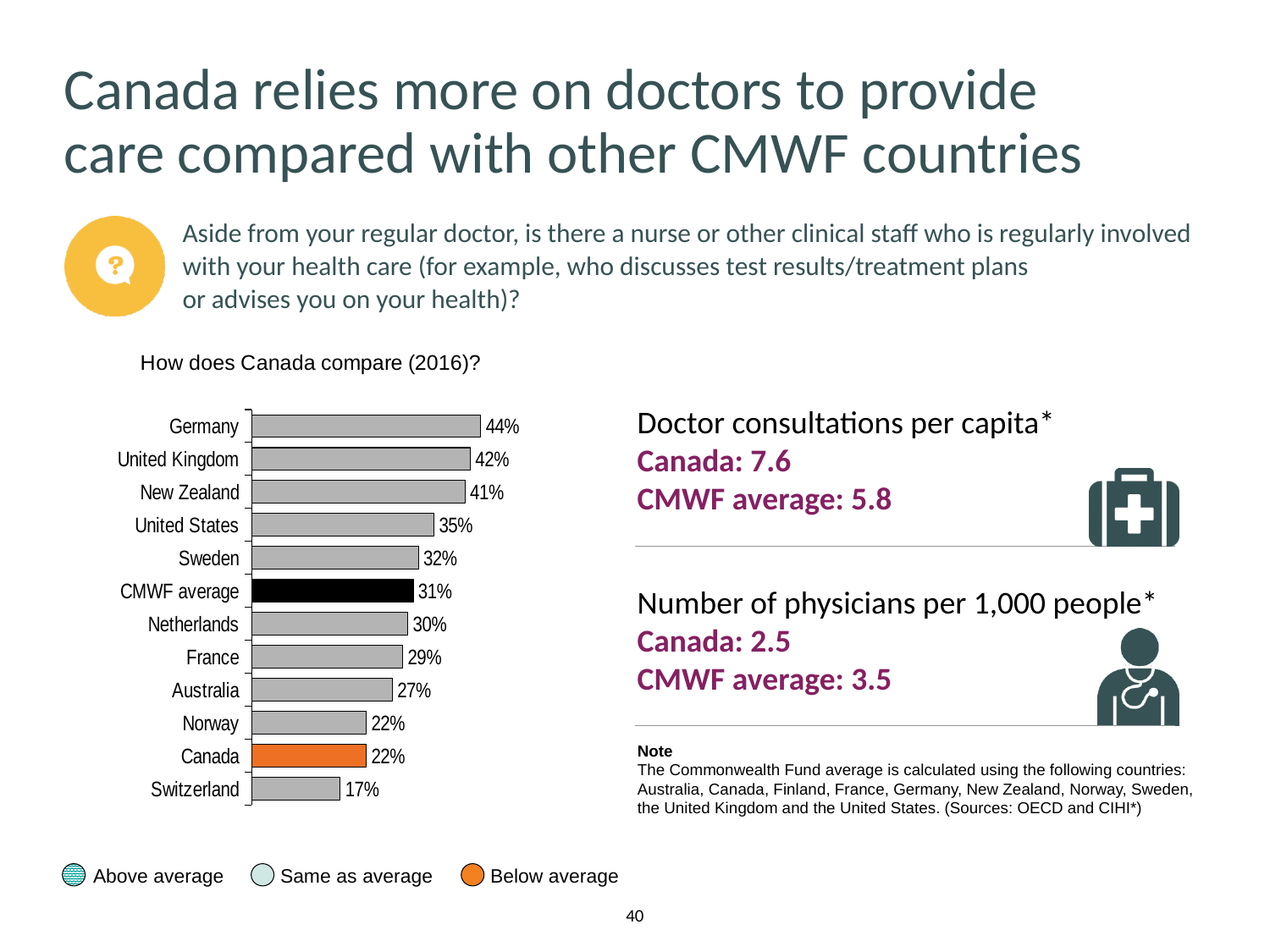
Which category has the lowest value? Switzerland What is the value for Germany? 44% Which category has the highest value? Germany What is the difference between the values for Germany and Canada? 22% Which is larger, the value for New Zealand or the value for Sweden? New Zealand What is the value for the CMWF average? 31% What is the value for Canada? 22% What is the value for the United States? 35% What is the difference between the CMWF average and Canada? 9% How many categories are shown in the bar chart? 12 What kind of chart is shown on the slide? Bar chart What colour is the bar for Canada? Orange